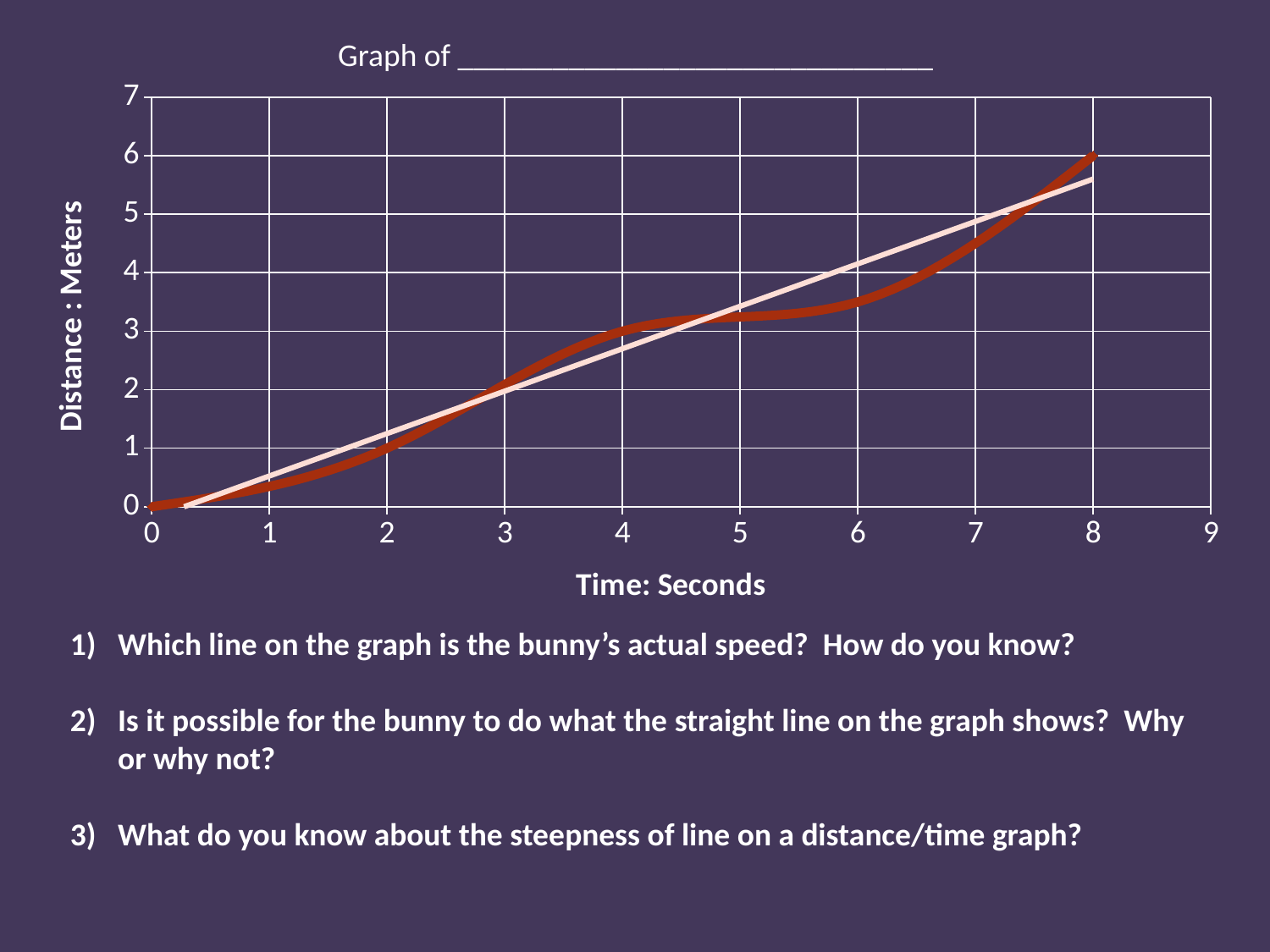
Is the value of the straight light pink line at 8 seconds greater or less than 5? greater At 8 seconds, which line shows the greater distance, the curved dark red line or the straight light pink line? the curved dark red line What is the title of the x axis? Time: Seconds How many lines are plotted on the chart? 2 Is the value of the curved dark red line at 6 seconds greater or less than 4? less What kind of chart is shown on the slide? line chart What distance does the curved dark red line reach at 8 seconds? 6 What is the distance of the curved dark red line at 0 seconds? 0 Does the distance shown by the curved dark red line rise or fall as time increases? rise At 6 seconds, which line shows the greater distance, the curved dark red line or the straight light pink line? the straight light pink line What is the title of the y axis? Distance : Meters Is the value of the straight light pink line at 4 seconds greater or less than 3? less